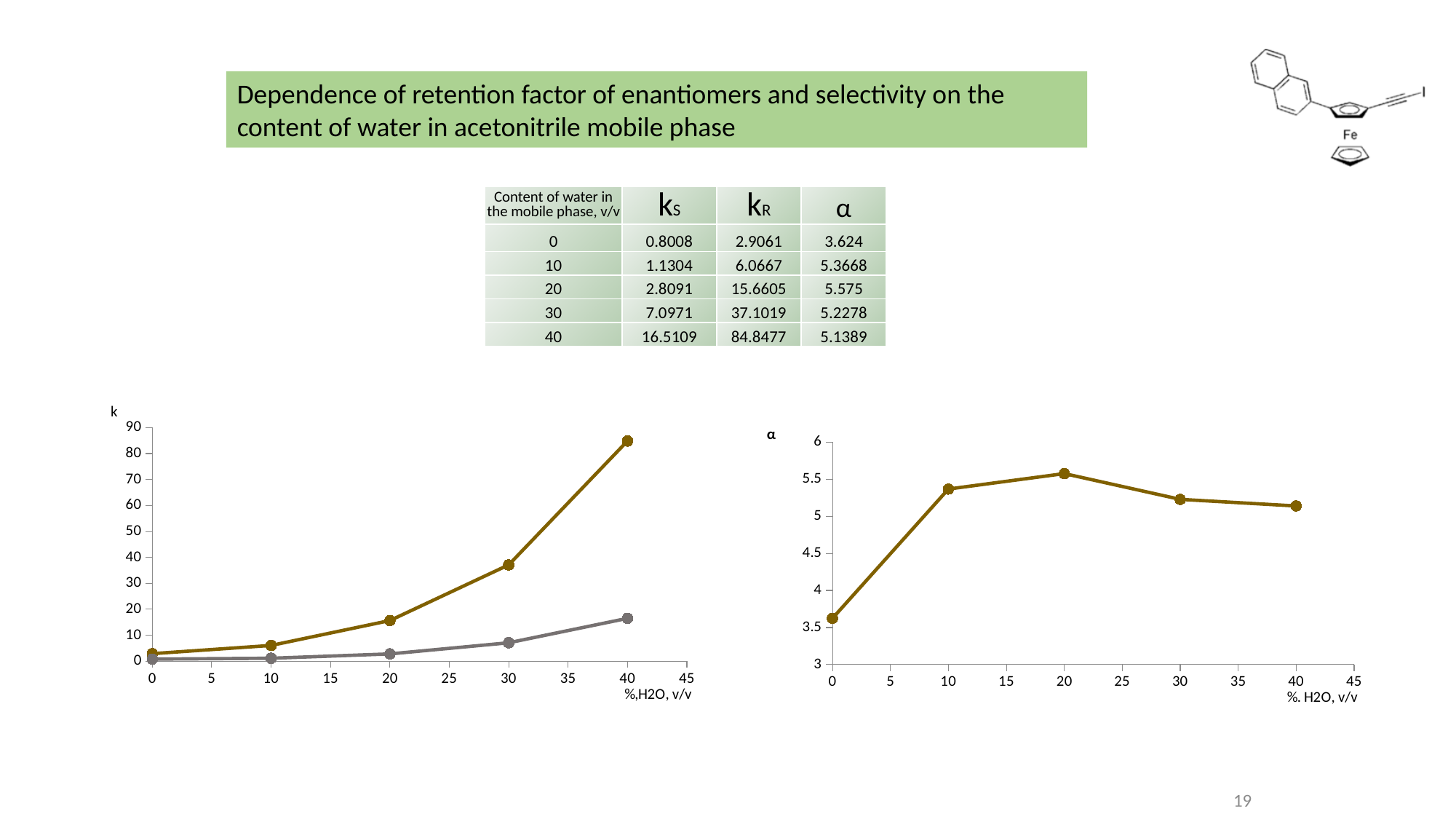
On the left chart (k), do the values rise or fall as the water content increases from 0 to 40? rise On the right chart (α), at which water content is the α value highest? 20 On the left chart (k), how many data points does each line have? 5 On the right chart (α), which is larger: the value at 10% H2O or the value at 40% H2O? 10% H2O On the right chart (α), is the value at 0% H2O greater or less than 4? less What kind of chart is the left chart (k versus %,H2O, v/v)? line chart On the left chart (k), how many lines are plotted? 2 On the right chart (α), at which water content is the α value lowest? 0 On the right chart (α), is the value at 10% H2O greater or less than 5? greater On the left chart (k), is the value of the upper (brown) line at 40% H2O greater or less than 80? greater What kind of chart is the right chart (α versus %. H2O, v/v)? line chart